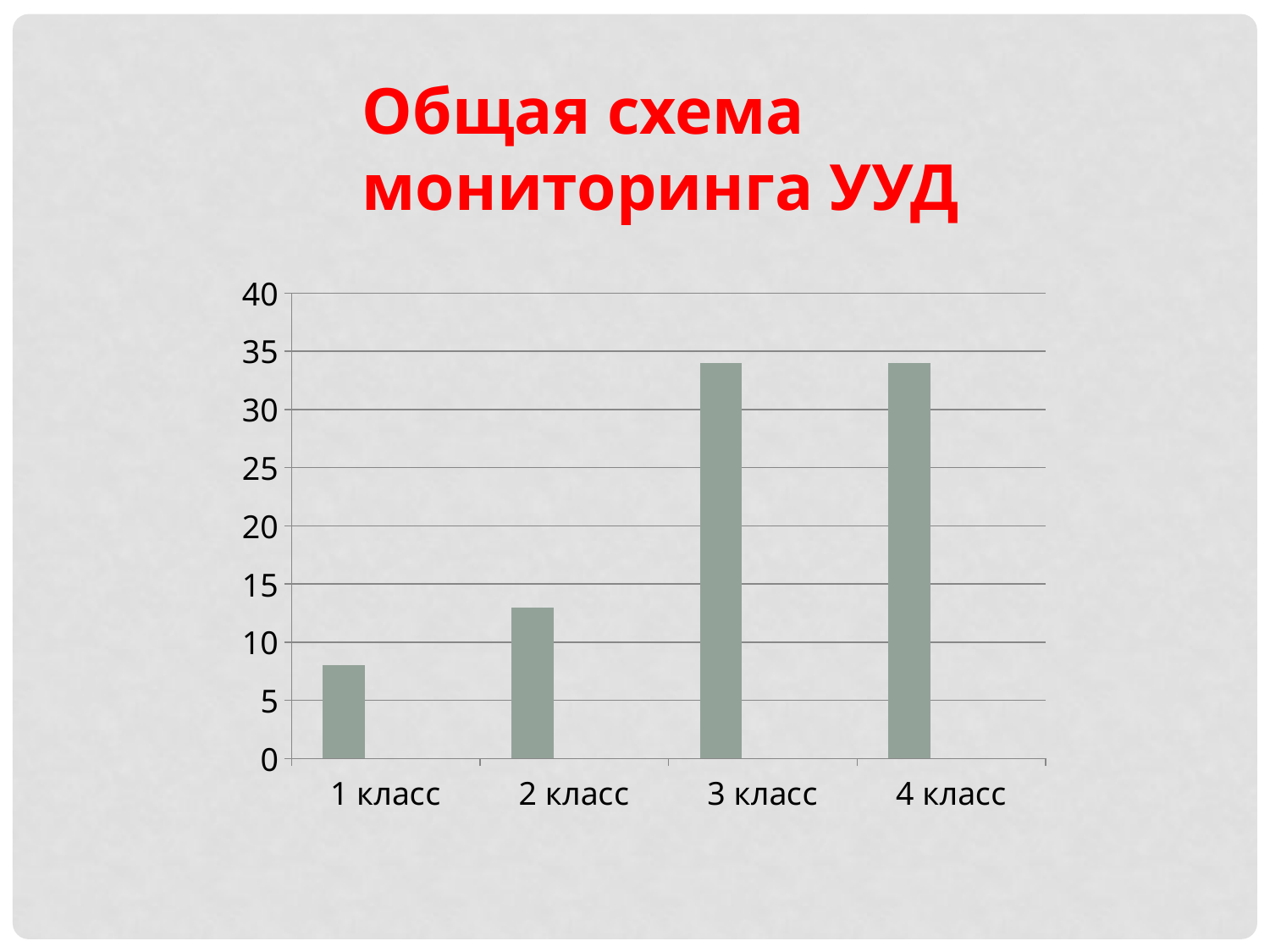
Which is larger, the value for 2 класс or the value for 3 класс? 3 класс What is the title shown above the chart on the slide? Общая схема мониторинга УУД Is the value for 3 класс greater or less than 30? greater Is the value for 2 класс greater or less than 10? greater How many categories are shown on the x axis of the chart? 4 Which category has the lowest bar in the chart? 1 класс Which is larger, the value for 1 класс or the value for 2 класс? 2 класс Is the value for 1 класс greater or less than 10? less What kind of chart is shown on the slide? bar chart Do the values rise or fall from 1 класс to 4 класс along the x axis? rise